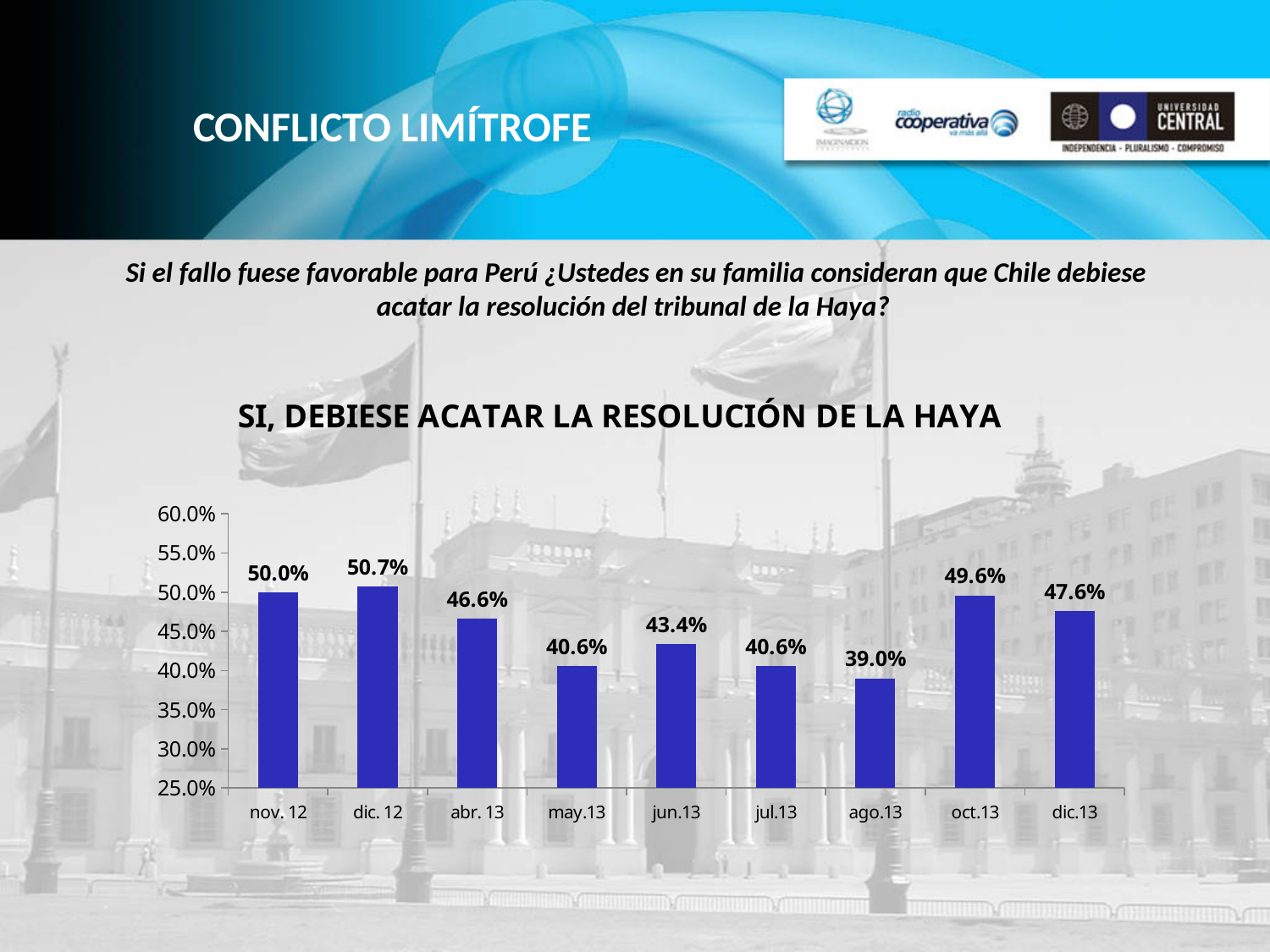
Which category has the highest value? dic. 12 How many categories are shown on the x axis? 9 Is the value for may.13 greater or less than 45.0%? less Which category has the lowest value? ago.13 What is the value for ago.13? 39.0% What kind of chart is shown on the slide? bar chart What is the difference between the values for dic. 12 and ago.13? 11.7% What is the title of the chart? SI, DEBIESE ACATAR LA RESOLUCIÓN DE LA HAYA What is the value for oct.13? 49.6% What is the value for dic. 12? 50.7% Which is larger, the value for abr. 13 or the value for jun.13? abr. 13 What is the difference between the values for oct.13 and dic.13? 2.0%